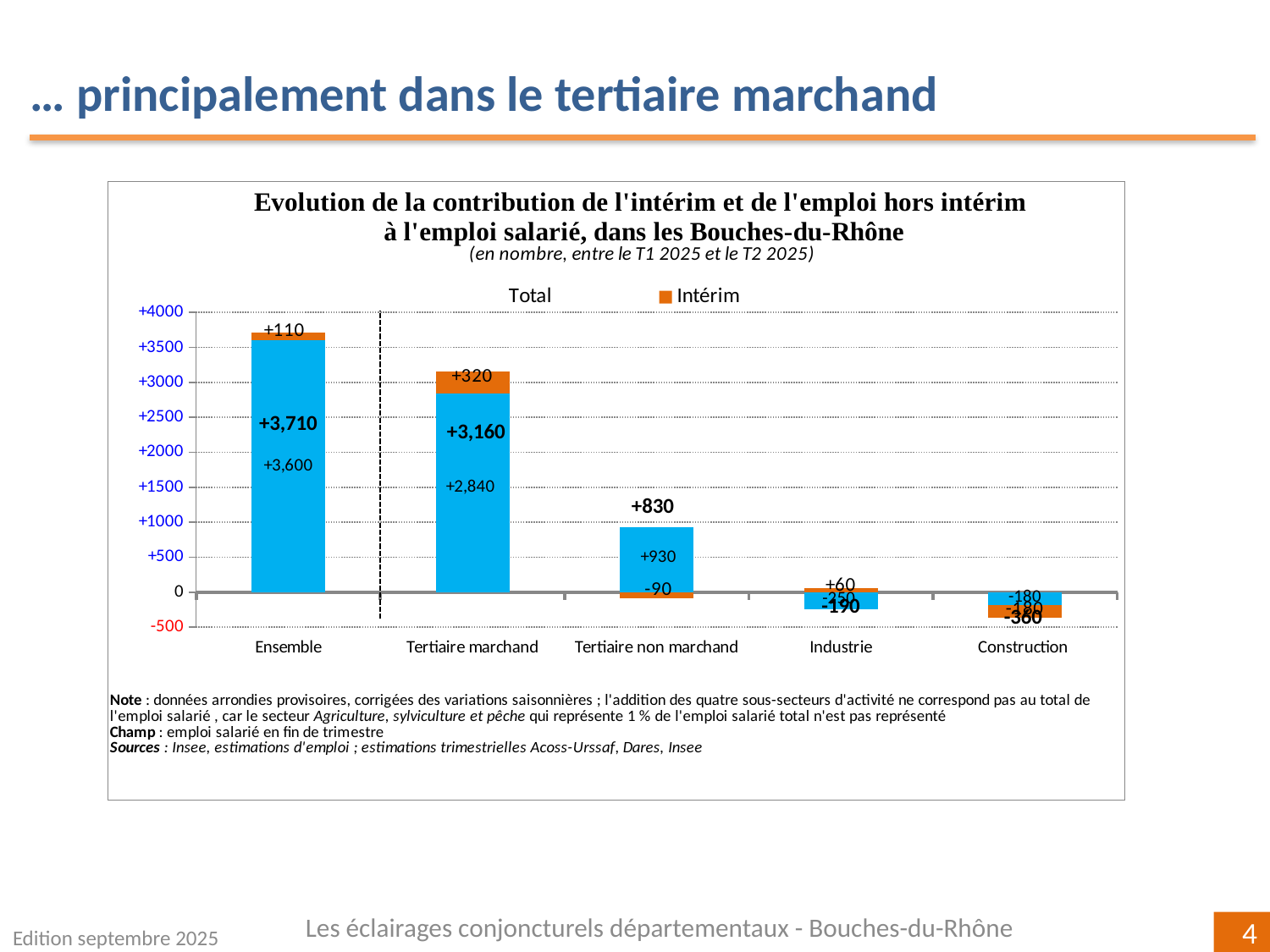
What kind of chart is shown on the slide? bar chart Which has the larger total value, Tertiaire marchand or Tertiaire non marchand? Tertiaire marchand Which category has the highest total value? Ensemble What is the Intérim value shown for Tertiaire non marchand? -90 What is the Intérim value shown for Ensemble? +110 How many sectors (categories) are shown on the x axis of the chart? 5 What is the total value shown for Tertiaire non marchand? +830 What is the total value shown for Ensemble? +3,710 What is the Intérim value shown for Tertiaire marchand? +320 What is the difference between the total value for Ensemble and the total value for Tertiaire marchand? 550 Which category has the lowest total value? Construction What is the total value shown for Tertiaire marchand? +3,160